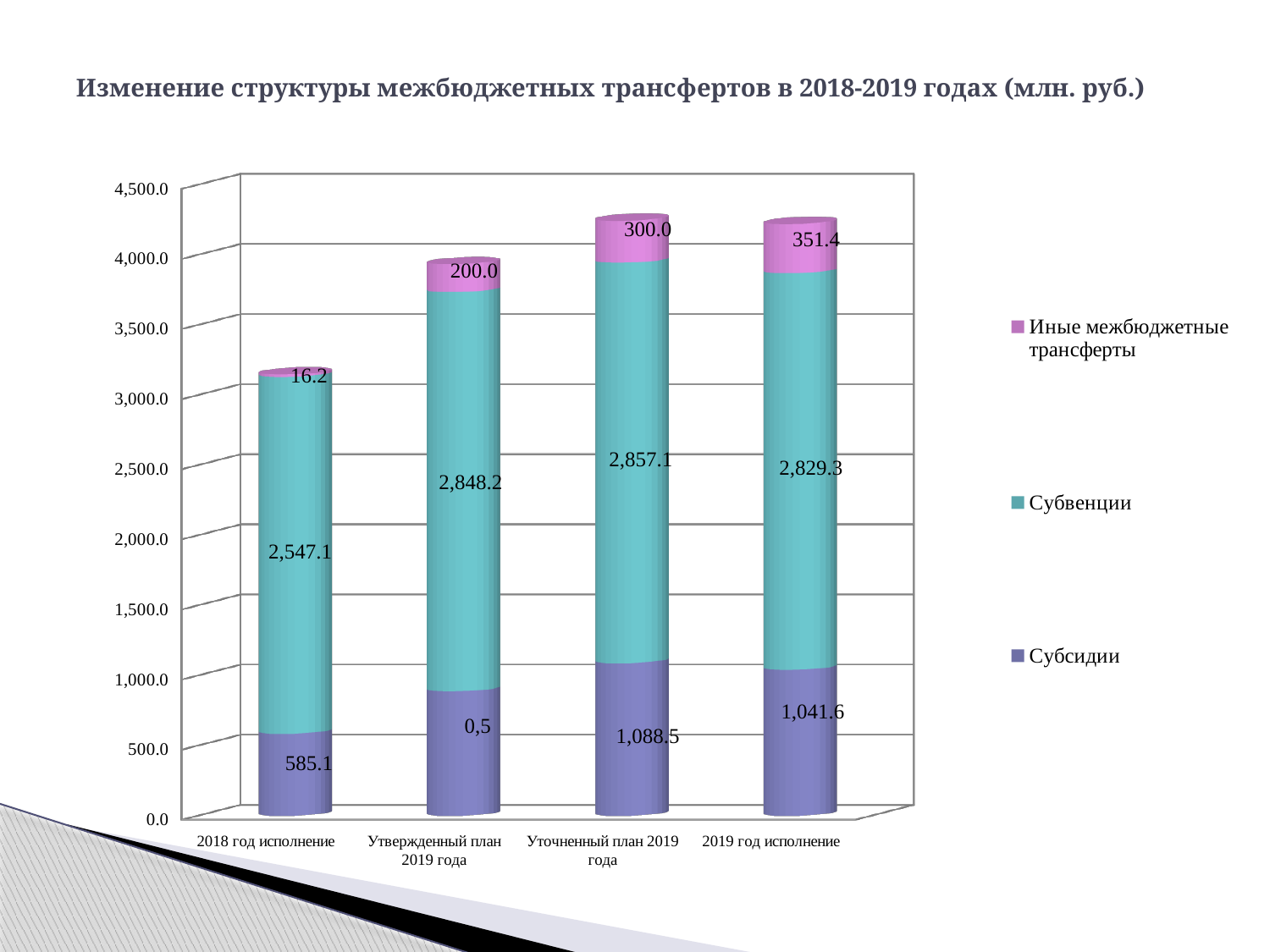
How many categories are shown along the x axis? 4 How many series does the legend list? 3 Which category has the highest value for Иные межбюджетные трансферты? 2019 год исполнение What is the value of Субсидии for 2019 год исполнение? 1,041.6 Which category has the lowest value for Иные межбюджетные трансферты? 2018 год исполнение Is the total height of the bar for Утвержденный план 2019 года greater or less than 3,500.0? greater What kind of chart is shown on the slide? Stacked bar chart What is the value of Субвенции for 2018 год исполнение? 2,547.1 What is the difference between Иные межбюджетные трансферты for 2019 год исполнение and for Уточненный план 2019 года? 51.4 Which is larger: Субвенции for Уточненный план 2019 года or Субвенции for 2019 год исполнение? Уточненный план 2019 года What is the total of the stacked bar for Уточненный план 2019 года? 4,245.6 What is the value of Иные межбюджетные трансферты for Уточненный план 2019 года? 300.0